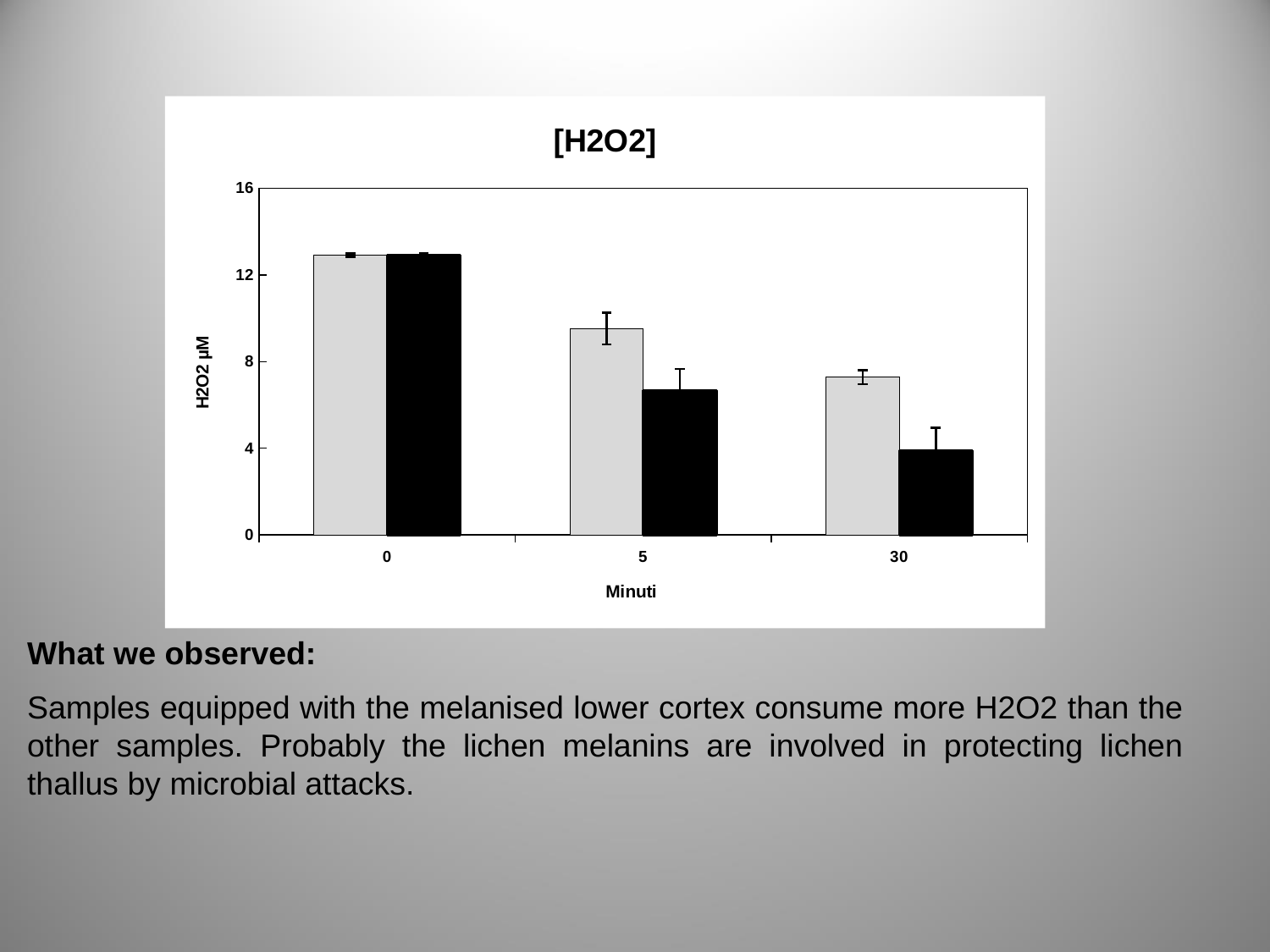
What kind of chart is shown on the slide? bar chart At which x-axis category is the black bar lowest? 30 Is the value of the light grey bar at 0 minutes greater or less than 12? greater How many bars are plotted for each x-axis category? 2 What is the title of the chart? [H2O2] Is the value of the light grey bar at 5 minutes greater or less than 8? greater Is the value of the black bar at 5 minutes greater or less than 8? less Do the values of the black bars rise or fall as the minutes increase along the x axis? fall At 30 minutes, which bar is larger, the light grey bar or the black bar? the light grey bar What is the label of the x axis? Minuti How many categories are shown on the x axis? 3